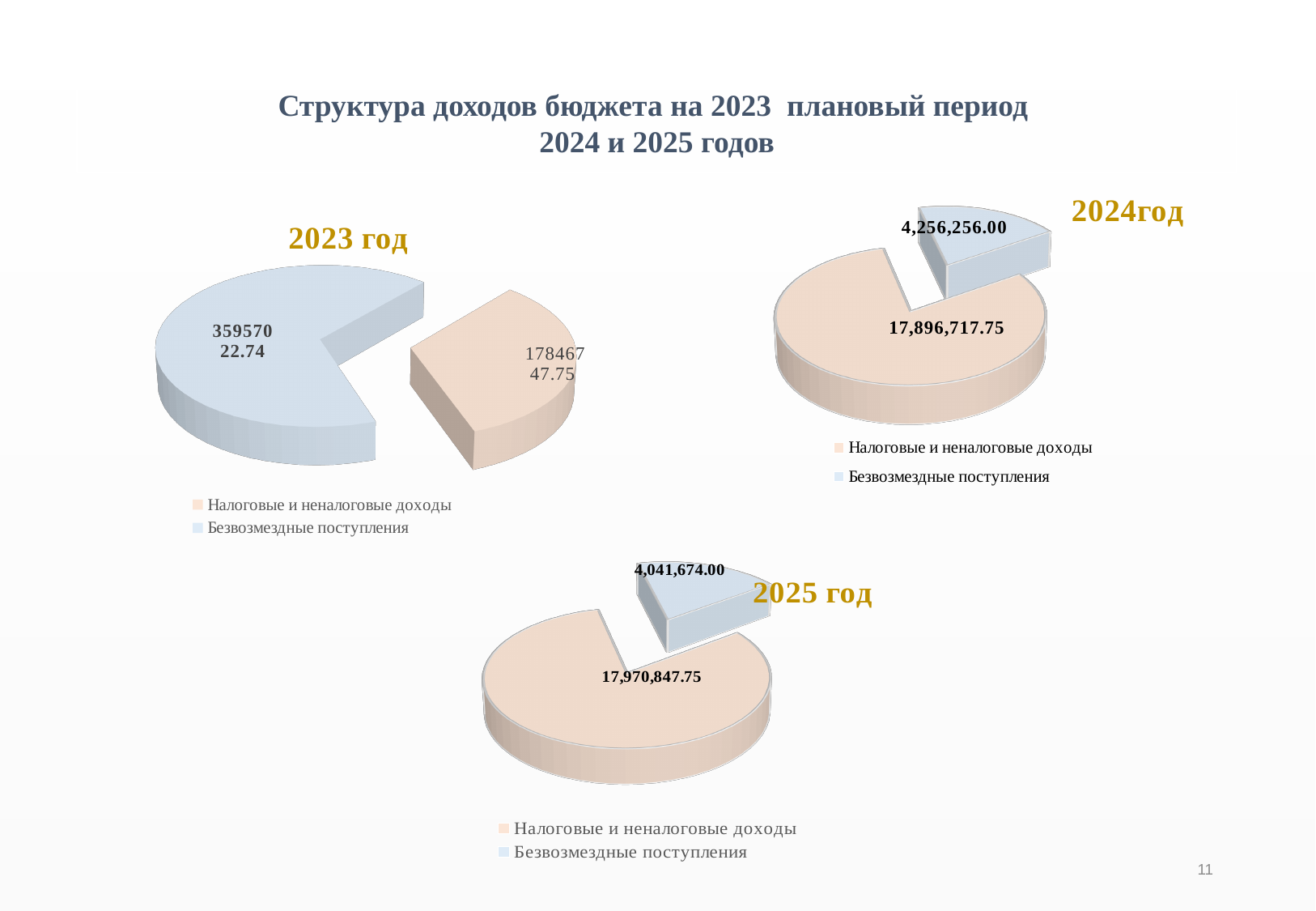
In the 2025 год chart, what is the value for Налоговые и неналоговые доходы? 17,970,847.75 In the 2024год chart, what is the value for Безвозмездные поступления? 4,256,256.00 In the 2024год chart, which category has the largest slice? Налоговые и неналоговые доходы In the 2024год chart, what is the value for Налоговые и неналоговые доходы? 17,896,717.75 How many entries does the legend of the 2024год chart list? 2 What kind of chart is used for the 2023 год chart? Pie chart In the 2024год chart, what is the difference between Налоговые и неналоговые доходы and Безвозмездные поступления? 13,640,461.75 How many slices does the 2025 год chart have? 2 In the 2025 год chart, what is the value for Безвозмездные поступления? 4,041,674.00 In the 2025 год chart, what is the total of the two slices? 22,012,521.75 In the 2023 год chart, which slice is larger: Налоговые и неналоговые доходы or Безвозмездные поступления? Безвозмездные поступления In the 2025 год chart, which category has the smallest slice? Безвозмездные поступления